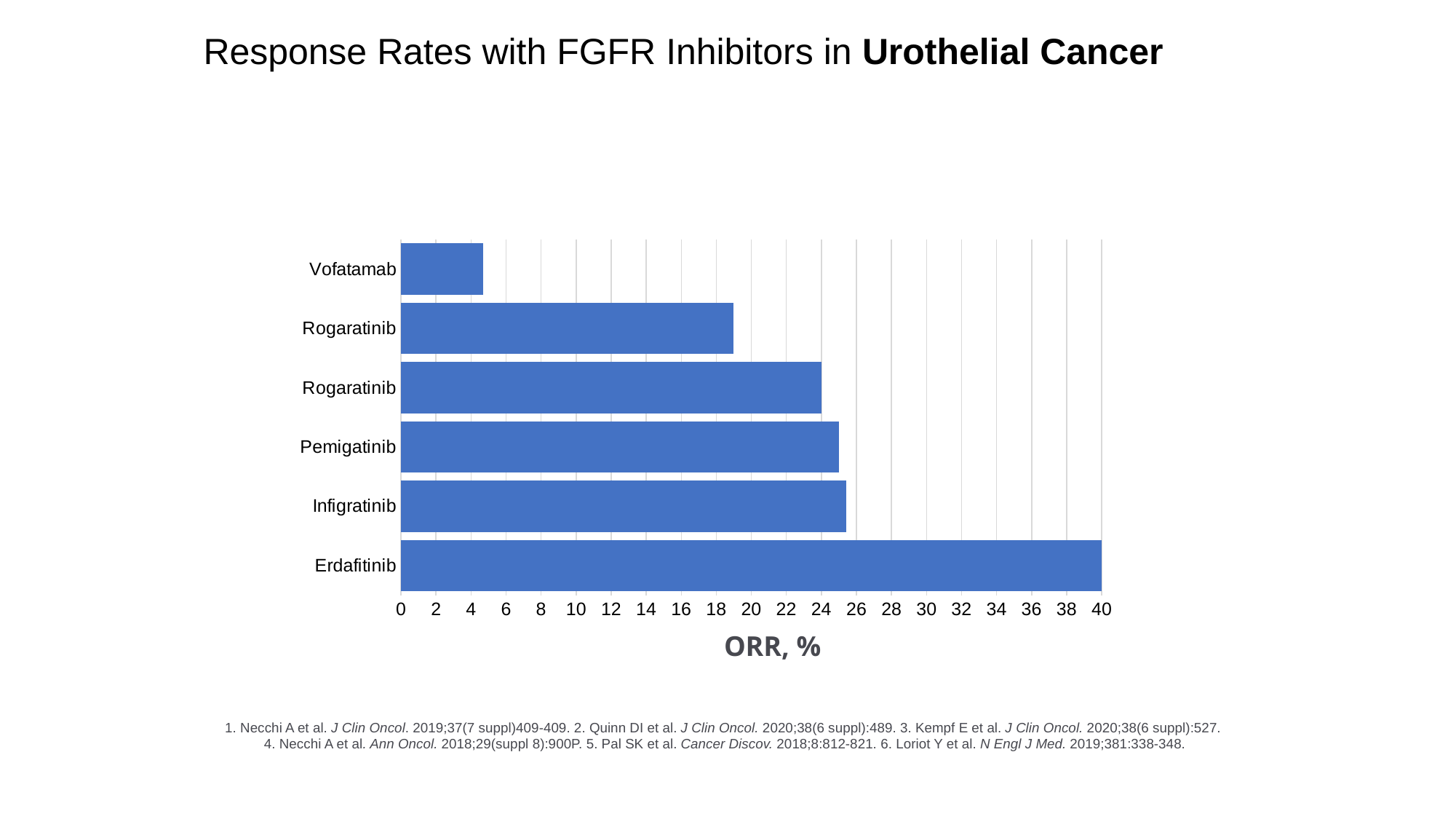
What is the label of the horizontal axis of the chart? ORR, % What kind of chart is shown on the slide? bar chart Is the ORR value for Infigratinib greater or less than 30? less Is the ORR value for Pemigatinib greater or less than 24? greater Is the ORR value for Erdafitinib greater or less than 30? greater Which drug has the lowest ORR in the chart? Vofatamab How many bars are plotted in the chart? 6 Which has a higher ORR, Vofatamab or Infigratinib? Infigratinib What is the ORR, % value for Erdafitinib? 40 Which has a higher ORR, Erdafitinib or Pemigatinib? Erdafitinib Which drug has the highest ORR in the chart? Erdafitinib